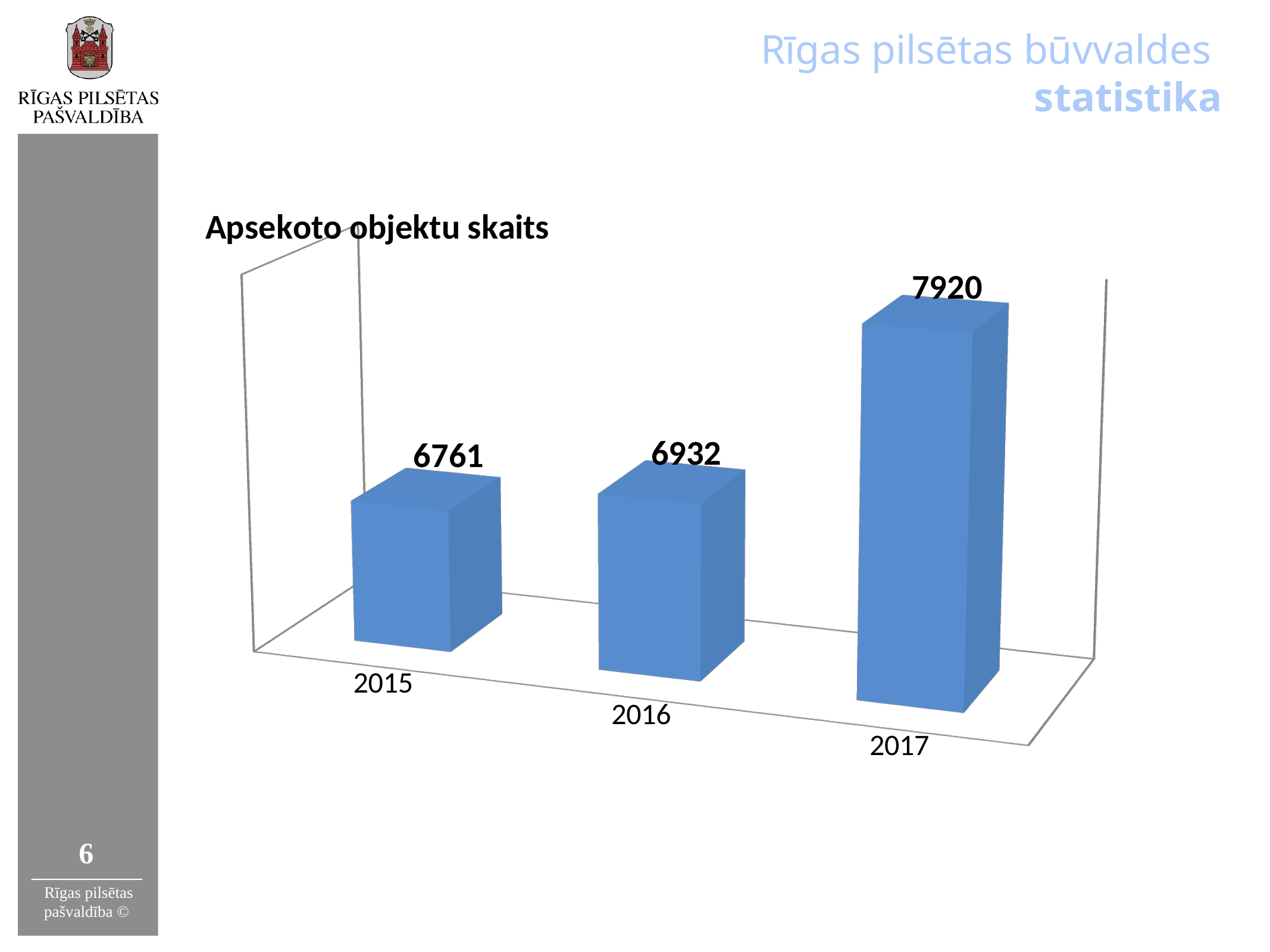
Which year has the lowest value? 2015 What is the value for 2016? 6932 What kind of chart is shown on the slide? bar chart Which year has the highest value? 2017 What is the value for 2015? 6761 How many years are shown on the chart? 3 What is the difference between the values for 2017 and 2016? 988 What is the title of the chart? Apsekoto objektu skaits Do the values rise or fall from 2015 to 2017? rise What is the difference between the values for 2016 and 2015? 171 Which is larger, the value for 2015 or the value for 2017? 2017 What is the value for 2017? 7920